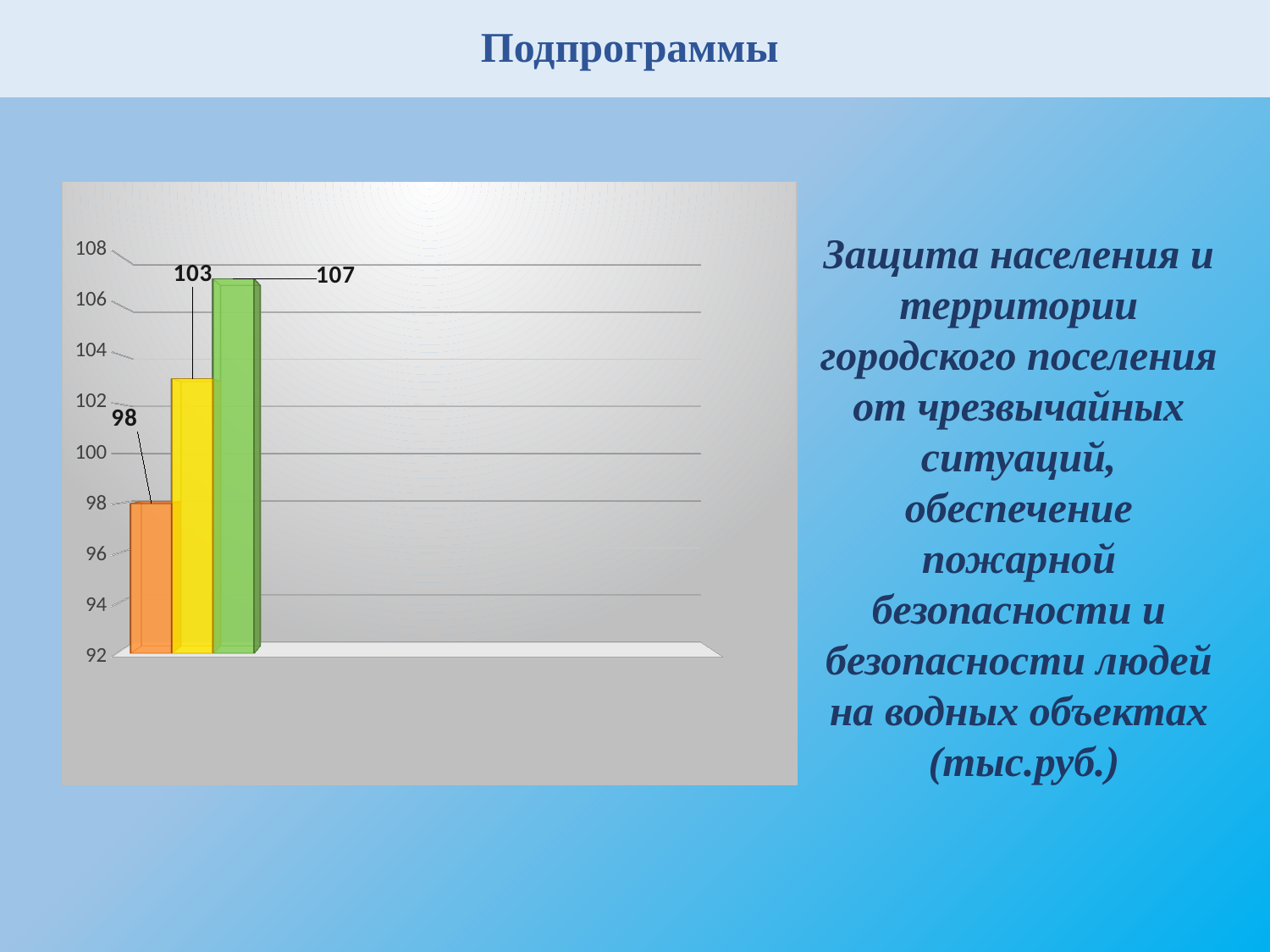
How many bars are plotted in the chart? 3 What value is shown for the yellow bar? 103 Is the value of the yellow bar greater or less than 100? greater What value is shown for the orange bar? 98 What is the difference between the yellow bar and the orange bar? 5 Which bar has the highest value? the green bar What value is shown for the green bar? 107 Which bar has the lowest value? the orange bar Do the bar values rise or fall from left to right? rise Which is larger, the yellow bar or the green bar? the green bar What is the difference between the green bar and the orange bar? 9 What kind of chart is shown on the slide? bar chart